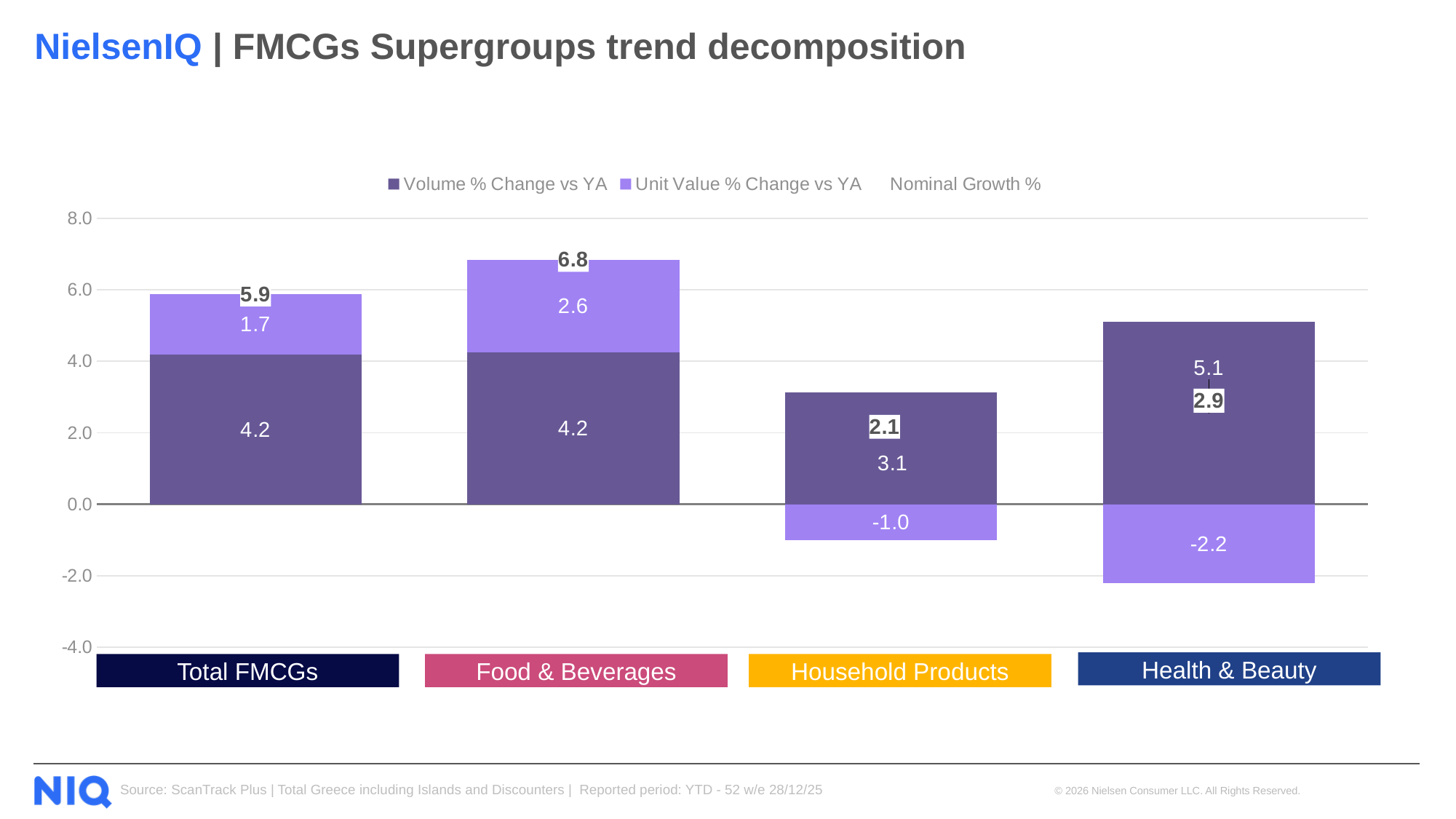
How many series does the legend list? 3 Is the Volume % Change vs YA for Total FMCGs greater or less than 4.0? greater How many categories are shown on the x axis? 4 Which category has the lowest Unit Value % Change vs YA? Health & Beauty What kind of chart is shown on the slide? Stacked bar chart Which is larger, the Volume % Change vs YA for Health & Beauty or for Household Products? Health & Beauty What is the Nominal Growth % for Household Products? 2.1 What is the difference between the Nominal Growth % for Food & Beverages and Total FMCGs? 0.9 Which category has the highest Nominal Growth %? Food & Beverages What is the Volume % Change vs YA for Health & Beauty? 5.1 What is the Unit Value % Change vs YA for Health & Beauty? -2.2 What is the Unit Value % Change vs YA for Food & Beverages? 2.6